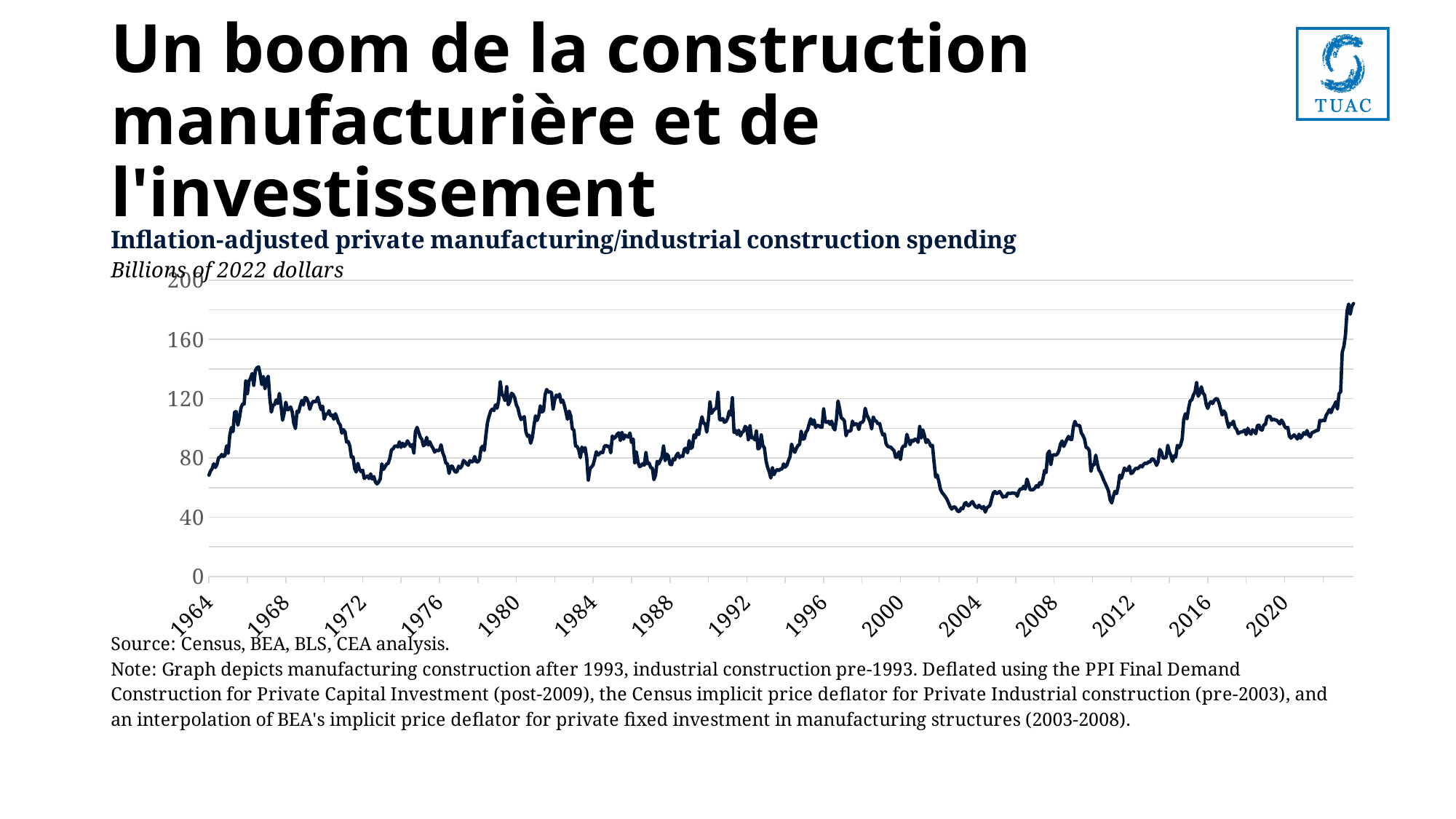
How many year labels are shown on the x axis? 15 What is the title of the chart? Inflation-adjusted private manufacturing/industrial construction spending What kind of chart is shown on the slide? Line chart Is the value of the line at the end of the series (after 2020) greater or less than 160? greater Is the peak of the line around 1967 greater or less than 120? greater Is the value of the line around 2011 greater or less than 80? less Does the line rise or fall between 2000 and 2004? fall Does the line rise or fall between 2020 and the end of the series? rise In what units are the values on the chart expressed? Billions of 2022 dollars